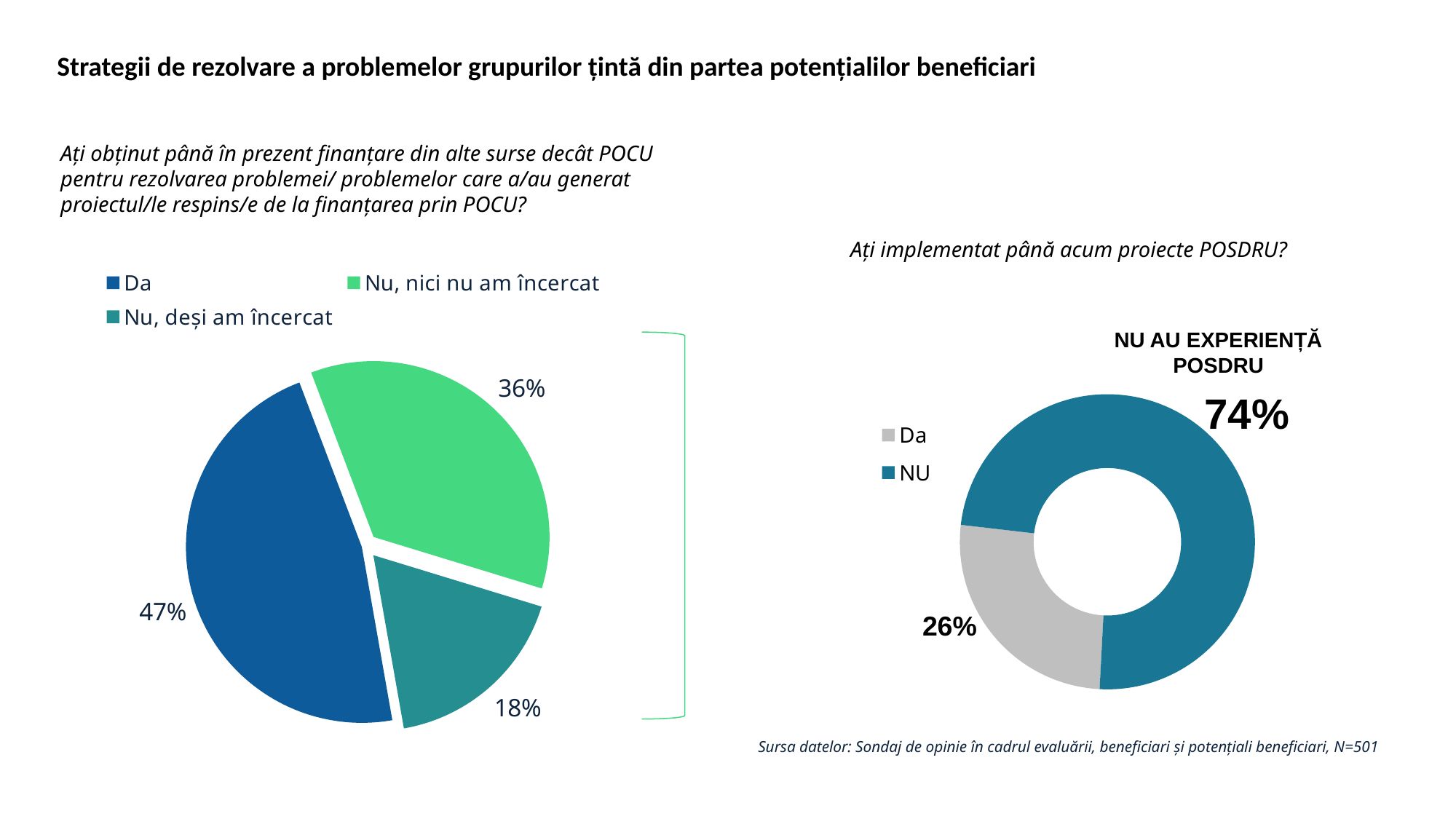
In the left pie chart, how many categories are shown? 3 In the right chart, what label is written above the 74% value? NU AU EXPERIENȚĂ POSDRU In the left pie chart, what share of respondents answered "Da"? 47% In the right chart, which is larger, the share for "Da" or the share for "NU"? NU In the right chart ("Ați implementat până acum proiecte POSDRU?"), what share of respondents answered "Da"? 26% In the left pie chart, what is the difference in percentage points between "Da" and "Nu, deși am încercat"? 29 In the left pie chart, which category has the smallest share? Nu, deși am încercat What type of chart is the chart on the right of the slide? Doughnut (pie) chart In the right chart ("Ați implementat până acum proiecte POSDRU?"), what share of respondents answered "NU"? 74% In the left pie chart, which category has the largest share? Da In the left pie chart, what share of respondents answered "Nu, deși am încercat"? 18% In the left pie chart, what share of respondents answered "Nu, nici nu am încercat"? 36%